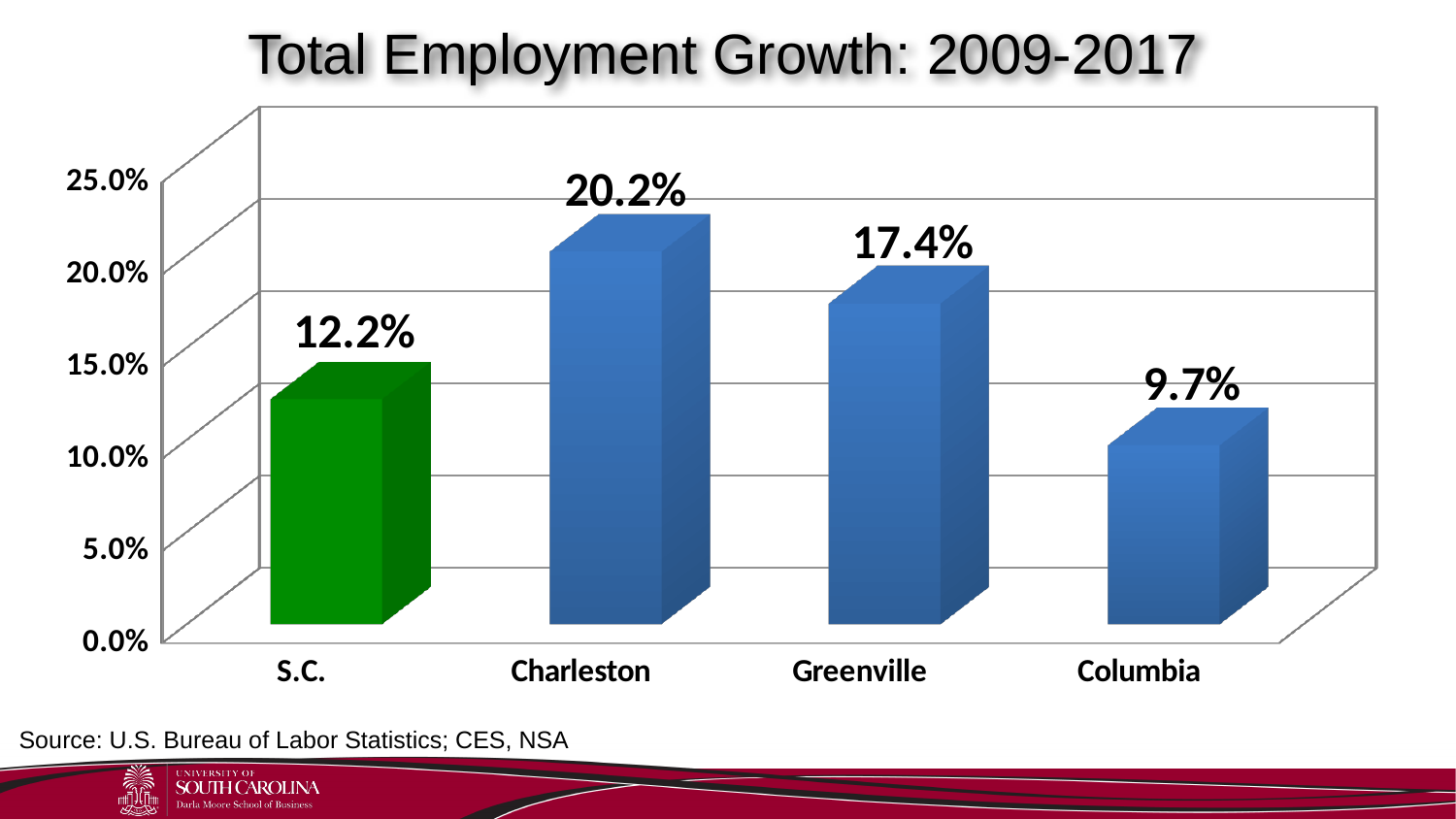
How many categories are shown on the chart? 4 What is the total employment growth value shown for Charleston? 20.2% Which bar is coloured green rather than blue? S.C. What kind of chart is shown on the slide? Bar chart What is the difference in employment growth between Charleston and Greenville? 2.8% What is the total employment growth value shown for Columbia? 9.7% What is the difference in employment growth between S.C. and Columbia? 2.5% Which category has the highest employment growth? Charleston Which has higher employment growth, Greenville or S.C.? Greenville Which category has the lowest employment growth? Columbia What is the total employment growth value shown for S.C.? 12.2% Is the value for Columbia greater or less than 10.0%? less